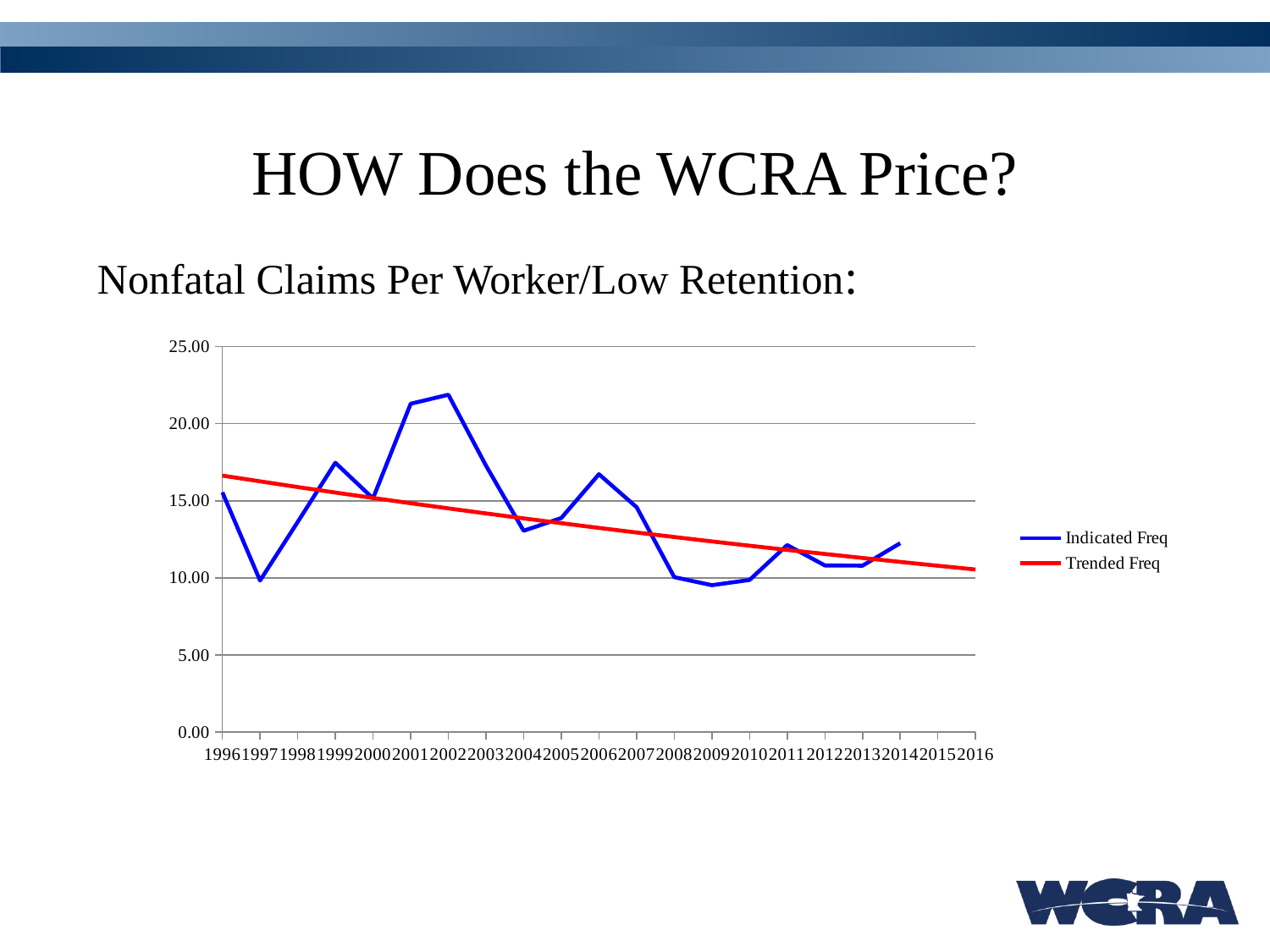
What kind of chart is shown on the slide? line chart How many years are labelled on the x axis? 21 Is the Indicated Freq value for 2002 greater or less than 20.00? greater Is the Indicated Freq value for 2008 greater or less than 15.00? less What colour is the Trended Freq line? red Which is larger for Indicated Freq: the value in 2002 or the value in 2009? 2002 What are the two series named in the legend? Indicated Freq and Trended Freq In 2002, which is larger: Indicated Freq or Trended Freq? Indicated Freq In which year does the Indicated Freq line reach its highest value? 2002 Does the Trended Freq line rise or fall from 1996 to 2016? fall Is the Trended Freq value for 1996 greater or less than 15.00? greater How many series does the legend list? 2